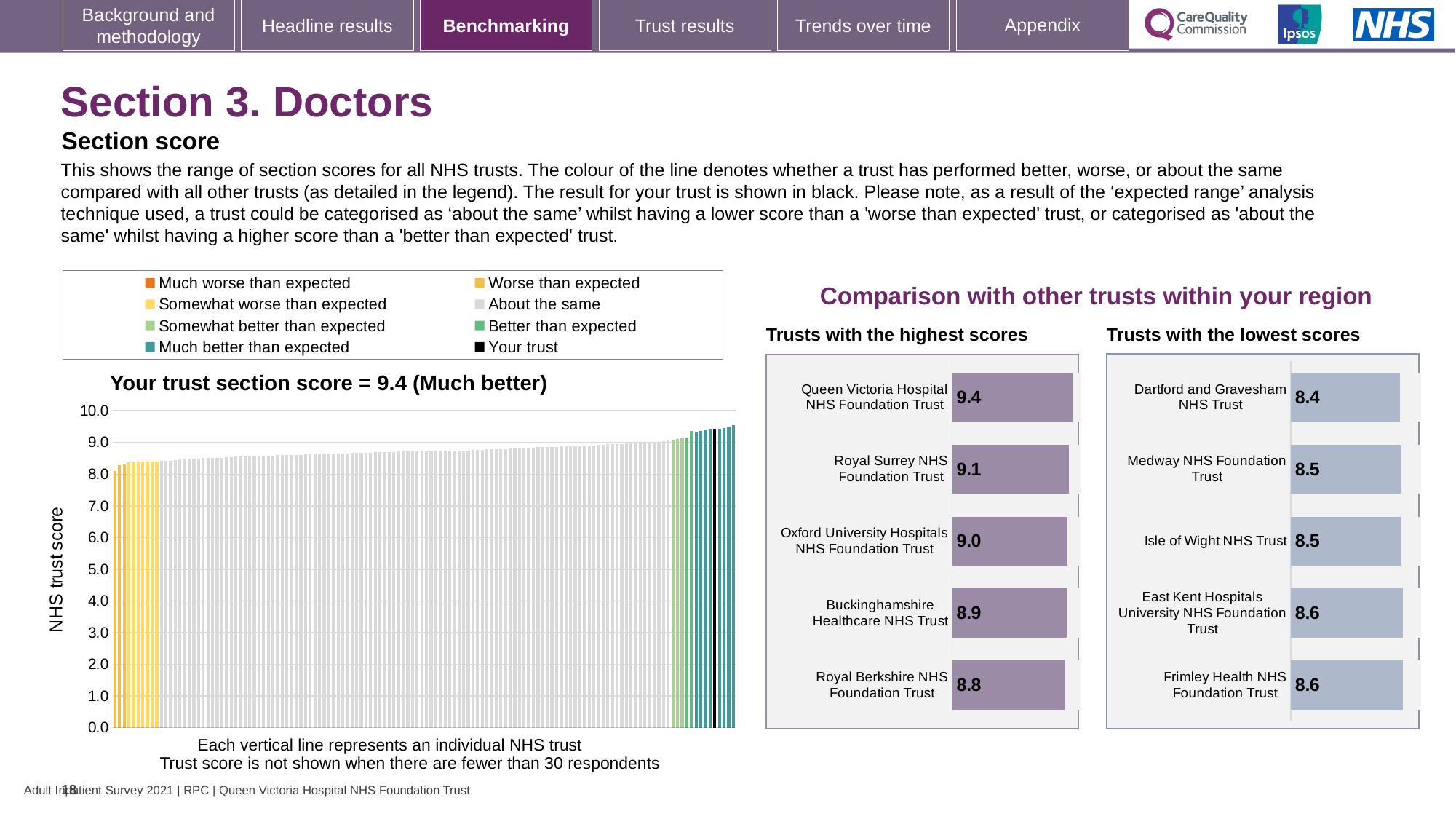
In the 'Trusts with the highest scores' chart, what is the score for Queen Victoria Hospital NHS Foundation Trust? 9.4 In the 'Trusts with the highest scores' chart, what is the score for Oxford University Hospitals NHS Foundation Trust? 9.0 How many trusts are shown in the 'Trusts with the highest scores' chart? 5 In the 'Trusts with the highest scores' chart, which trust has the lowest score? Royal Berkshire NHS Foundation Trust What kind of chart is the 'Your trust section score' chart on the left? Bar chart In the 'Your trust section score' chart on the left, do the values rise or fall from left to right along the x axis? Rise How many entries does the legend above the 'Your trust section score' chart list? 8 In the 'Trusts with the lowest scores' chart, what is the score for East Kent Hospitals University NHS Foundation Trust? 8.6 In the 'Trusts with the highest scores' chart, what is the difference between the scores of Queen Victoria Hospital NHS Foundation Trust and Royal Berkshire NHS Foundation Trust? 0.6 In the 'Trusts with the lowest scores' chart, what is the score for Dartford and Gravesham NHS Trust? 8.4 In the 'Trusts with the lowest scores' chart, which trust has the lowest score? Dartford and Gravesham NHS Trust In the 'Trusts with the lowest scores' chart, which has the larger score: Medway NHS Foundation Trust or Dartford and Gravesham NHS Trust? Medway NHS Foundation Trust